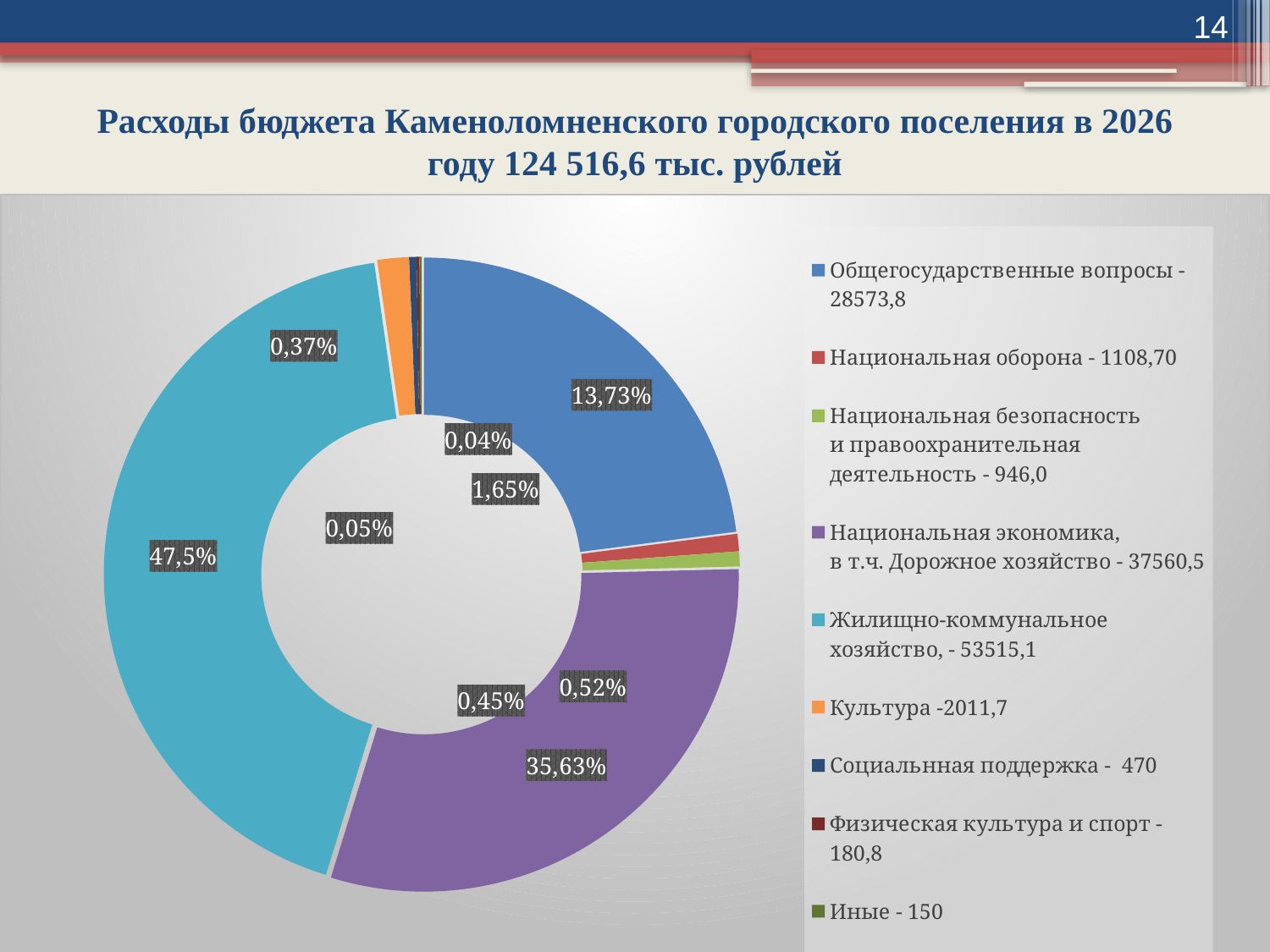
What value does the legend give for Жилищно-коммунальное хозяйство? 53515,1 What type of chart is shown on the slide? Doughnut (pie) chart Which category has the smallest expenditure according to the legend? Иные What is the difference between the legend values for Жилищно-коммунальное хозяйство and Национальная экономика? 15954,6 What percentage share is labelled on the Национальная экономика (purple) slice? 35,63% What value does the legend give for Национальная экономика, в т.ч. Дорожное хозяйство? 37560,5 What is the total budget expenditure stated in the chart title for 2026? 124 516,6 тыс. рублей What value does the legend give for Культура? 2011,7 Which category has the largest expenditure according to the legend? Жилищно-коммунальное хозяйство How many expenditure categories does the legend list? 9 What percentage share is labelled on the Жилищно-коммунальное хозяйство (teal) slice? 47,5% Which is larger according to the legend: Национальная оборона or Национальная безопасность и правоохранительная деятельность? Национальная оборона